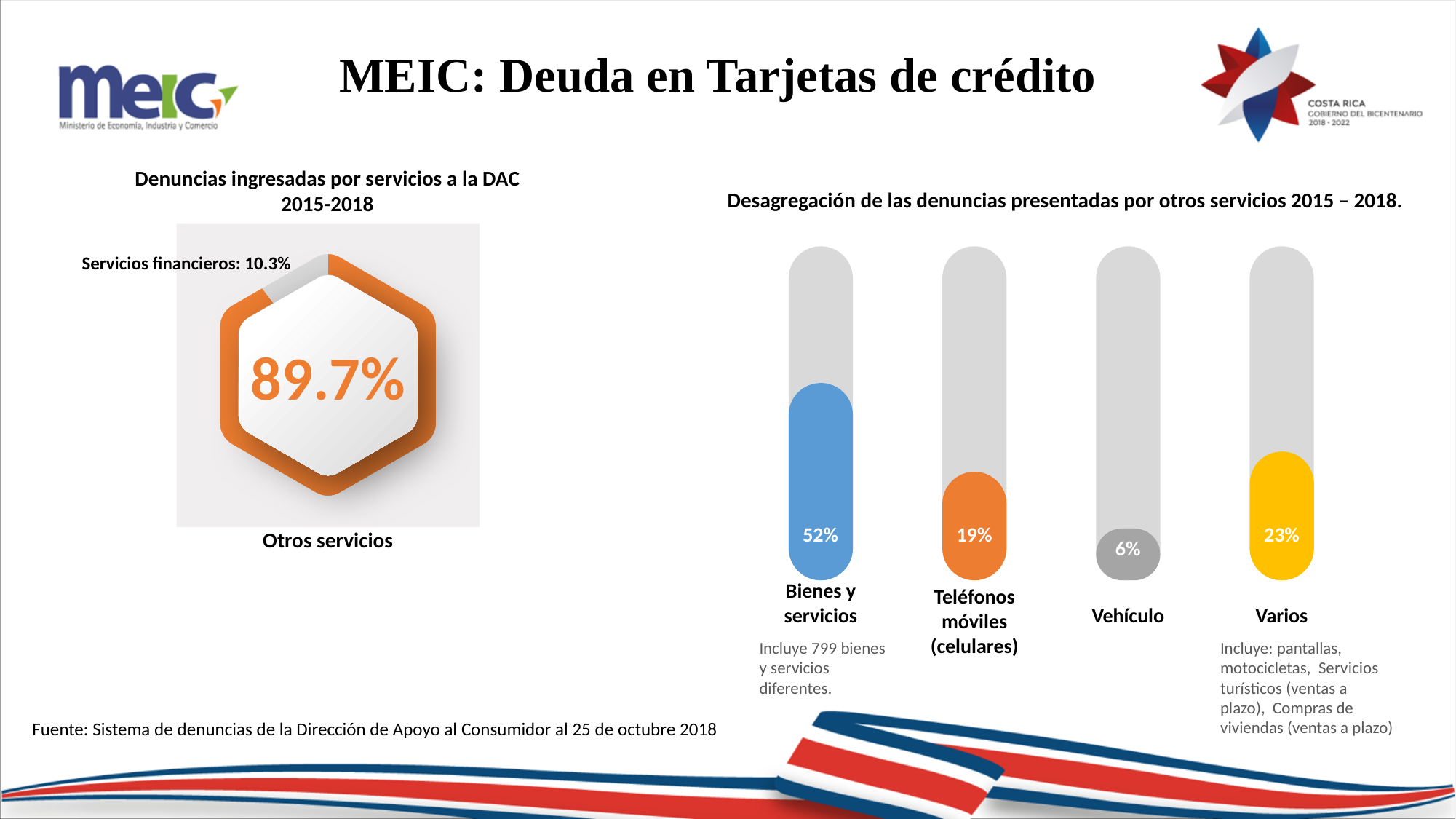
In the chart 'Desagregación de las denuncias presentadas por otros servicios 2015 – 2018', which is larger: Varios or Teléfonos móviles (celulares)? Varios In the chart 'Desagregación de las denuncias presentadas por otros servicios 2015 – 2018', what is the value for Teléfonos móviles (celulares)? 19% In the chart 'Desagregación de las denuncias presentadas por otros servicios 2015 – 2018', which category has the lowest value? Vehículo In the chart 'Desagregación de las denuncias presentadas por otros servicios 2015 – 2018', what is the value for Vehículo? 6% What kind of chart is 'Desagregación de las denuncias presentadas por otros servicios 2015 – 2018'? Bar chart How many categories are shown in the chart 'Desagregación de las denuncias presentadas por otros servicios 2015 – 2018'? 4 In the chart 'Denuncias ingresadas por servicios a la DAC 2015-2018', what is the share for Servicios financieros? 10.3% In the chart 'Desagregación de las denuncias presentadas por otros servicios 2015 – 2018', what colour is the bar for Varios? Yellow In the chart 'Denuncias ingresadas por servicios a la DAC 2015-2018', what is the share for Otros servicios? 89.7% In the chart 'Desagregación de las denuncias presentadas por otros servicios 2015 – 2018', what is the difference between Bienes y servicios and Varios? 29% In the chart 'Desagregación de las denuncias presentadas por otros servicios 2015 – 2018', what is the value for Bienes y servicios? 52% In the chart 'Desagregación de las denuncias presentadas por otros servicios 2015 – 2018', which category has the highest value? Bienes y servicios